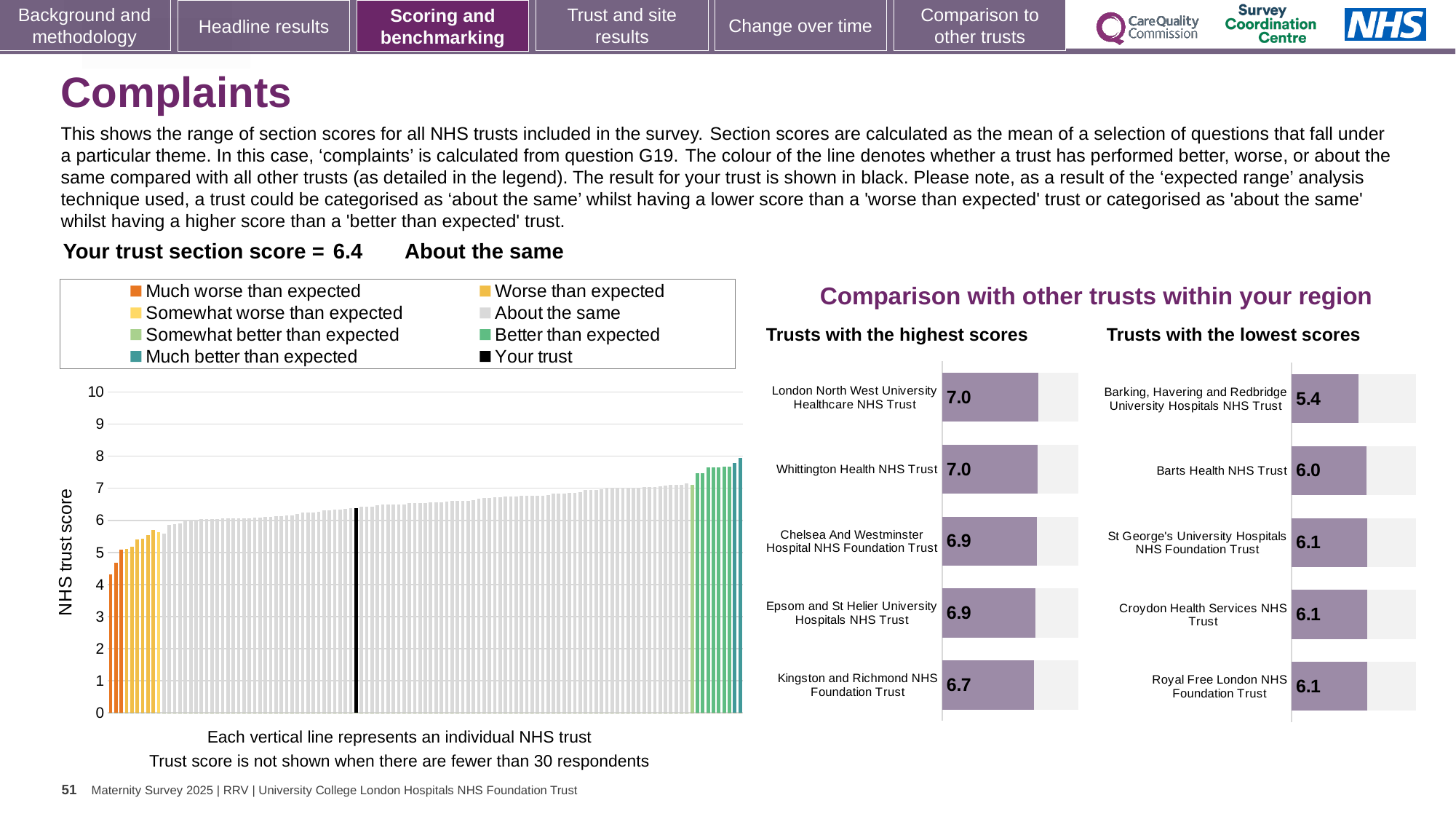
How many entries does the legend above the NHS trust score chart list? 8 In the 'Trusts with the lowest scores' chart, which trust has the lowest score? Barking, Havering and Redbridge University Hospitals NHS Trust In the 'Trusts with the highest scores' chart, what is the score for Chelsea And Westminster Hospital NHS Foundation Trust? 6.9 In the 'Trusts with the highest scores' chart, what is the difference between the score for London North West University Healthcare NHS Trust and the score for Kingston and Richmond NHS Foundation Trust? 0.3 In the NHS trust score chart on the left, is the value of the lowest bar greater or less than 5? less How many trusts are shown in the 'Trusts with the lowest scores' chart? 5 In the NHS trust score chart on the left, do the bar values rise or fall from left to right? rise In the NHS trust score chart on the left, what is the section score for your trust (the black bar)? 6.4 In the 'Trusts with the highest scores' chart, what is the score for Kingston and Richmond NHS Foundation Trust? 6.7 In the 'Trusts with the lowest scores' chart, what is the difference between the score for Barts Health NHS Trust and the score for Barking, Havering and Redbridge University Hospitals NHS Trust? 0.6 In the 'Trusts with the highest scores' chart, which has the higher score: Whittington Health NHS Trust or Kingston and Richmond NHS Foundation Trust? Whittington Health NHS Trust In the 'Trusts with the lowest scores' chart, what is the score for Barking, Havering and Redbridge University Hospitals NHS Trust? 5.4